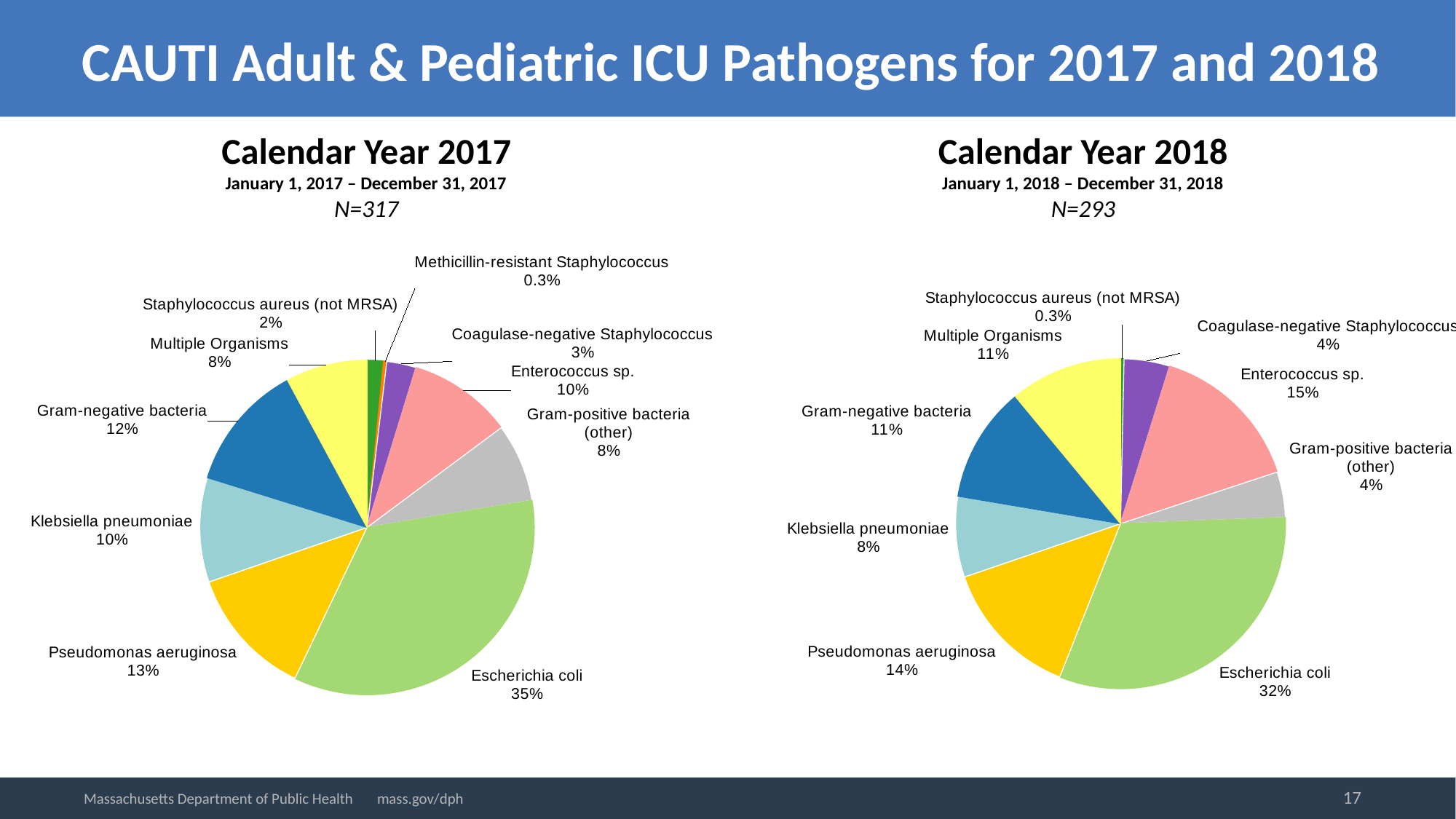
In the Calendar Year 2017 chart, what share is Methicillin-resistant Staphylococcus? 0.3% What is the N value shown for the Calendar Year 2018 chart? N=293 In the Calendar Year 2018 chart, what share is Enterococcus sp.? 15% In the Calendar Year 2018 chart, which is larger: the share of Pseudomonas aeruginosa or the share of Klebsiella pneumoniae? Pseudomonas aeruginosa How many pathogen categories are labeled in the Calendar Year 2018 chart? 9 In the Calendar Year 2018 chart, what share is Gram-positive bacteria (other)? 4% In the Calendar Year 2017 chart, what share is Escherichia coli? 35% In the Calendar Year 2017 chart, what is the difference between the shares of Pseudomonas aeruginosa and Klebsiella pneumoniae? 3% How many pathogen categories are labeled in the Calendar Year 2017 chart? 10 In the Calendar Year 2017 chart, which pathogen has the largest share? Escherichia coli In the Calendar Year 2018 chart, which pathogen has the smallest share? Staphylococcus aureus (not MRSA) What kind of charts are shown on the slide? Pie charts